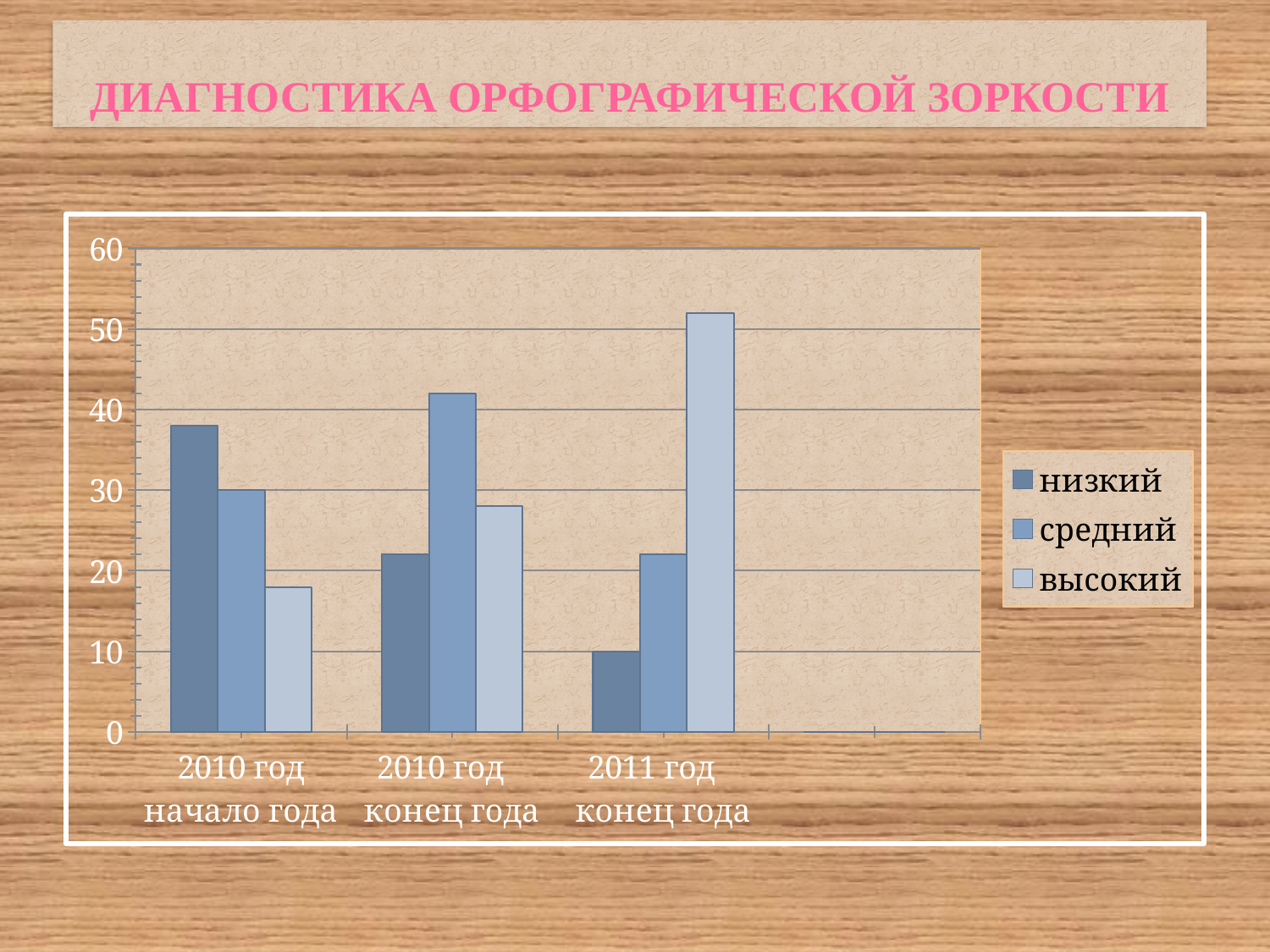
Which series has the tallest bar in the whole chart? высокий (2011 год конец года) Which is larger for 2010 год конец года: средний or высокий? средний Is the value for высокий in 2010 год начало года greater or less than 20? less Does the value for низкий rise or fall from 2010 год начало года to 2011 год конец года? fall Which series has the highest value for 2010 год начало года? низкий How many categories are shown on the x axis? 3 Is the value for средний in 2010 год конец года greater or less than 40? greater Is the value for низкий in 2010 год начало года greater or less than 30? greater Which series has the lowest value for 2011 год конец года? низкий What kind of chart is shown on the slide? bar chart How many series does the legend list? 3